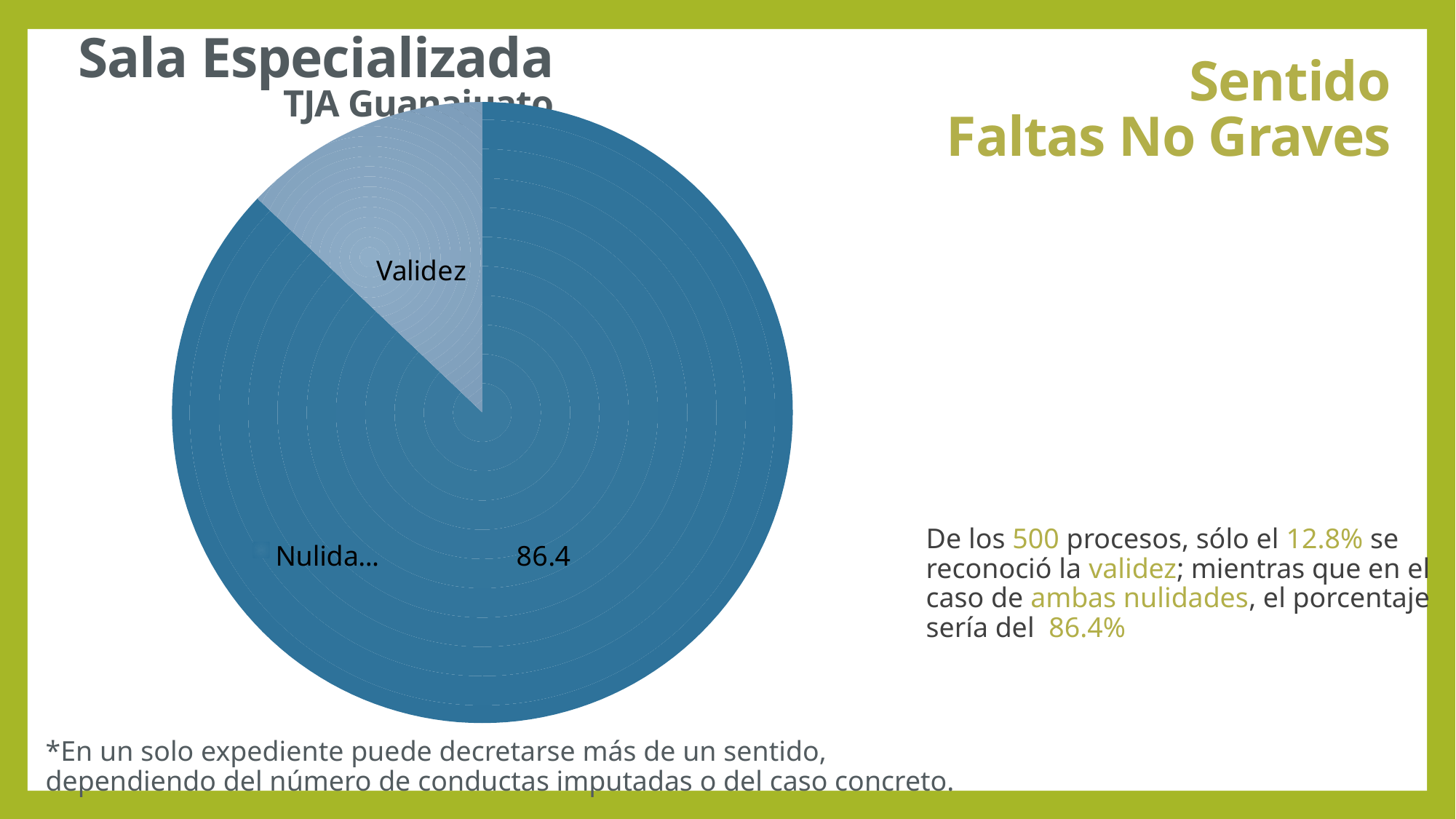
Which slice of the pie chart is the smallest? Validez How many slices does the pie chart have? 2 What colour is the 'Validez' slice of the pie chart? light blue What value is printed on the dark blue slice labelled 'Nulida…'? 86.4 Which slice of the pie chart is the largest? Nulida… Which slice is larger, 'Validez' or 'Nulida…'? Nulida… What kind of chart is shown on the slide? pie chart Is the share of the 'Nulida…' slice greater or less than 50? greater Is the share of the 'Validez' slice greater or less than 50? less What is the title shown in the top right of the slide above the chart's description? Sentido Faltas No Graves What share of the pie does the slice labelled 'Nulida…' represent? 86.4